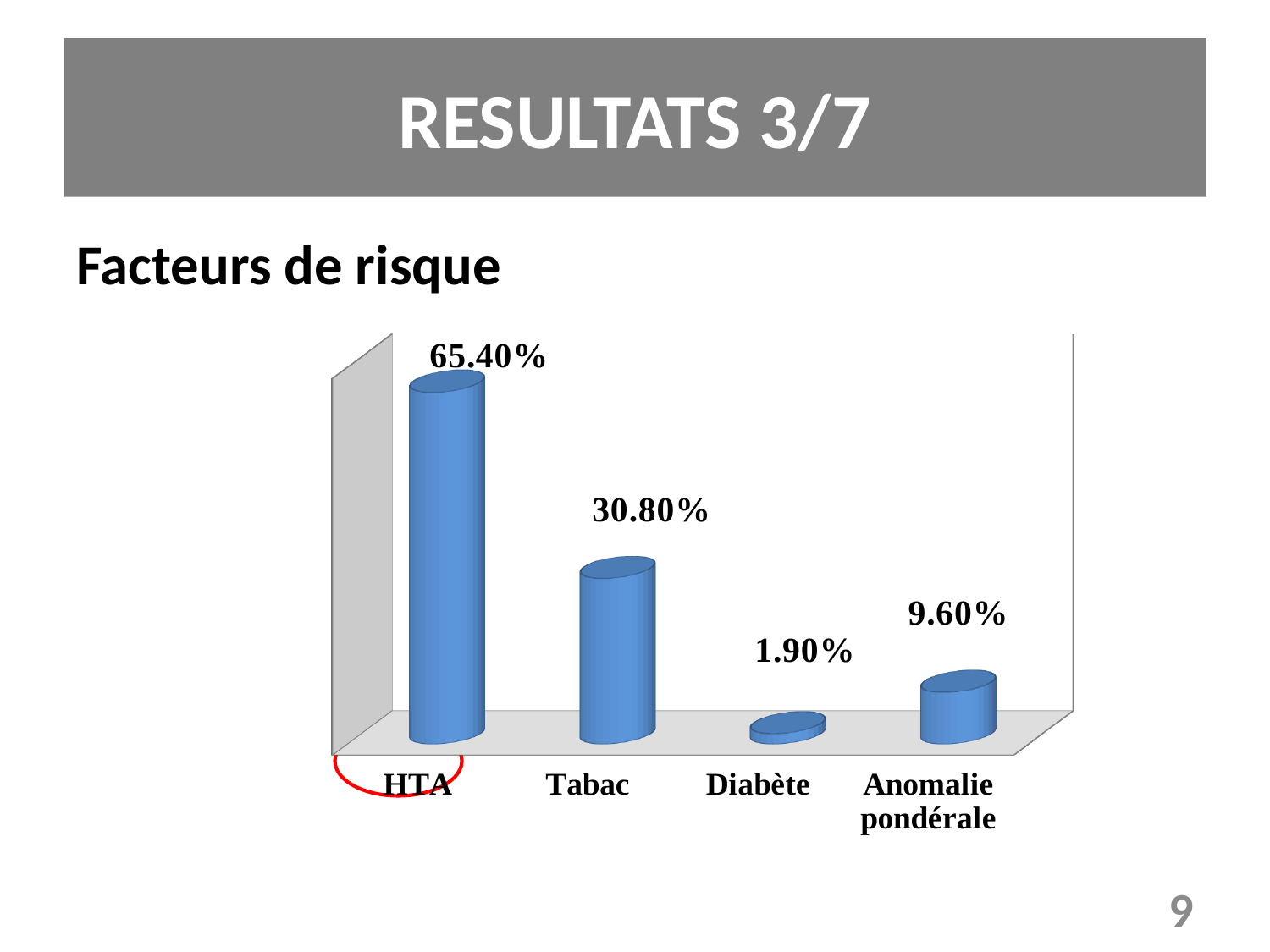
What is the value for Tabac? 30.80% What is the value for HTA? 65.40% Which risk factor has the highest value? HTA What is the value for Diabète? 1.90% What is the difference between the values for Anomalie pondérale and Diabète? 7.70% What is the difference between the values for HTA and Tabac? 34.60% How many categories are shown on the chart? 4 Which is larger, the value for Tabac or the value for Anomalie pondérale? Tabac What is the value for Anomalie pondérale? 9.60% Which risk factor has the lowest value? Diabète What kind of chart is shown on the slide? Bar chart Which category on the chart is circled in red? HTA